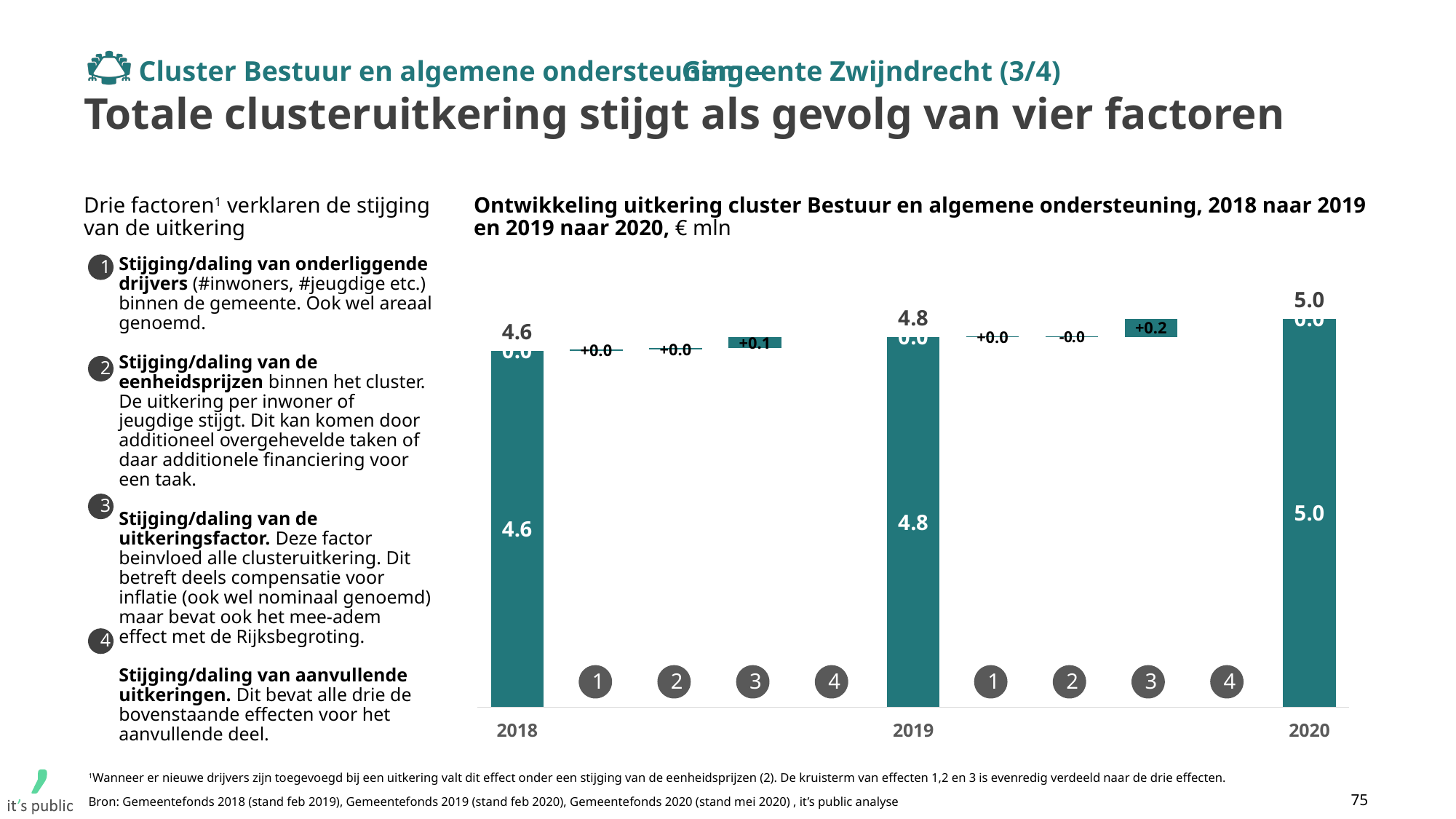
Which year has the lowest total cluster payment? 2018 What is the effect of factor 2 on the change from 2019 to 2020? -0.0 Is the total for 2019 larger or smaller than the total for 2020? smaller In what unit are the values in the chart expressed? € mln What is the effect of factor 3 on the change from 2019 to 2020? +0.2 What is the total cluster payment shown for 2020? 5.0 Which year has the highest total cluster payment? 2020 What is the effect of factor 3 on the change from 2018 to 2019? +0.1 What is the difference between the 2020 and 2018 total cluster payments? 0.4 Do the total cluster payments rise or fall from 2018 to 2020? rise What is the total cluster payment shown for 2018? 4.6 What is the total cluster payment shown for 2019? 4.8